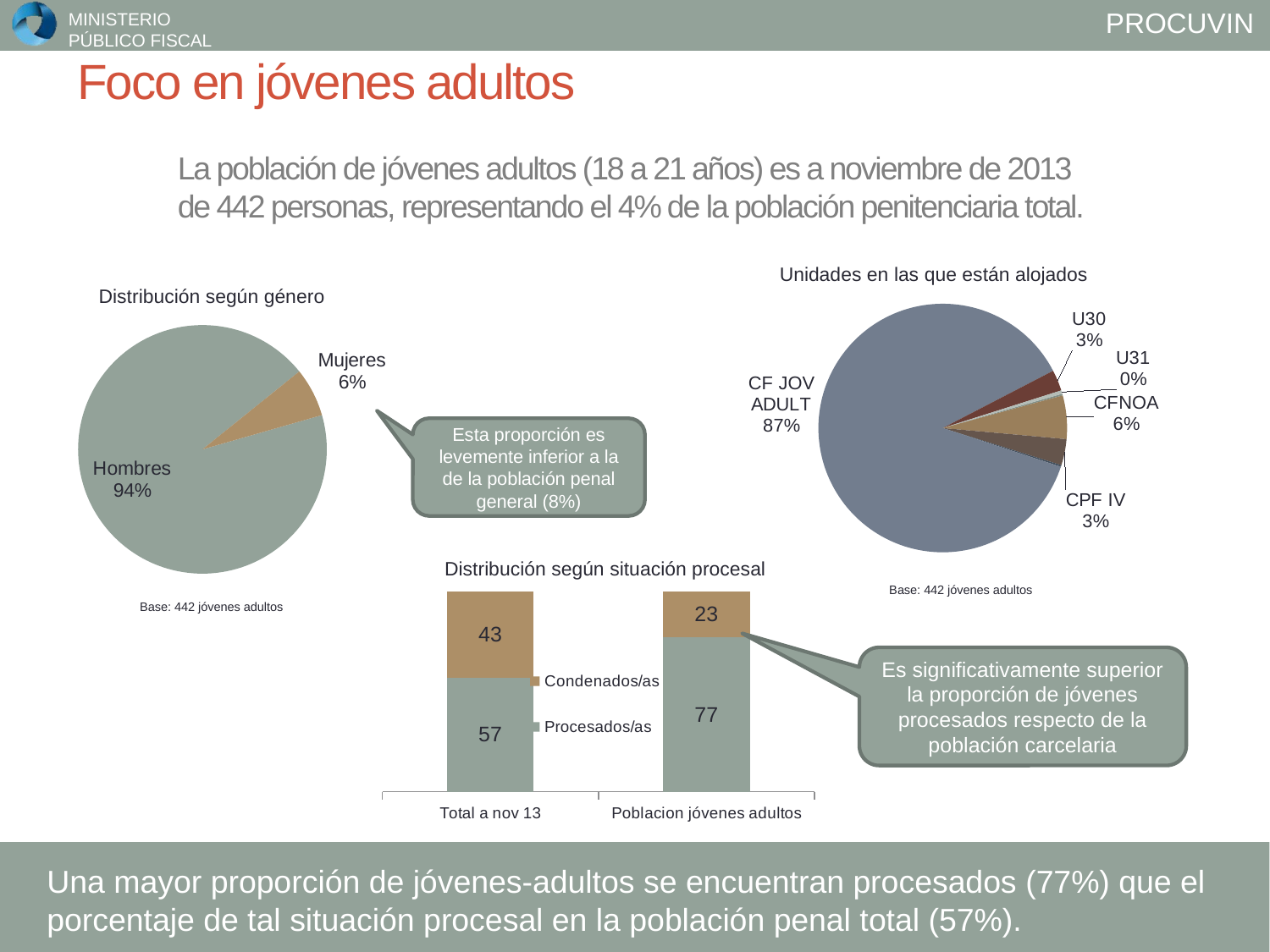
In the 'Unidades en las que están alojados' chart, what percentage is shown for CF JOV ADULT? 87% How many series does the legend of the 'Distribución según situación procesal' chart list? 2 What kind of chart is 'Distribución según género'? Pie chart In the 'Unidades en las que están alojados' chart, which unit has the largest share? CF JOV ADULT In the 'Unidades en las que están alojados' chart, what percentage is shown for CFNOA? 6% In the 'Distribución según género' chart, what percentage is shown for Mujeres? 6% In the 'Distribución según género' chart, what percentage is shown for Hombres? 94% In the 'Distribución según situación procesal' chart, what is the Condenados/as value for Total a nov 13? 43 How many units are labelled in the 'Unidades en las que están alojados' chart? 5 In the 'Distribución según situación procesal' chart, what is the Procesados/as value for Poblacion jóvenes adultos? 77 In the 'Distribución según situación procesal' chart, what is the difference between the Procesados/as values for Poblacion jóvenes adultos and Total a nov 13? 20